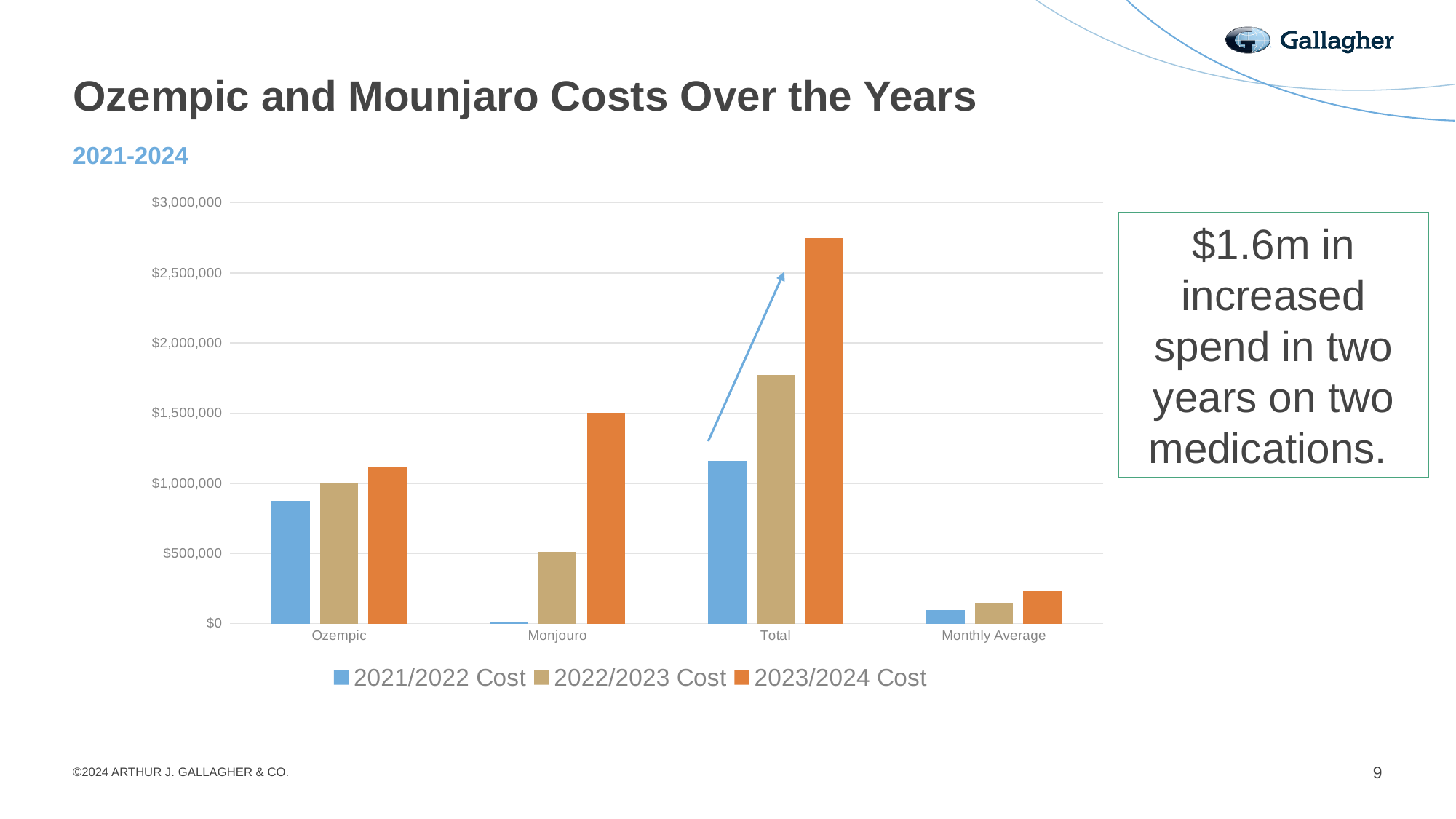
Is the 2023/2024 Cost value for Total greater or less than $2,500,000? greater How many categories are shown on the x axis of the chart? 4 Which colour represents the 2023/2024 Cost series in the chart? Orange Which category and series has the smallest bar in the chart? Monjouro, 2021/2022 Cost For the 2023/2024 Cost series, which is larger: Ozempic or Monjouro? Monjouro For the Total category, do the values rise or fall from 2021/2022 Cost to 2023/2024 Cost? Rise What kind of chart is shown on the slide? Bar chart Is the 2022/2023 Cost value for Total greater or less than $1,500,000? greater How many series does the chart's legend list? 3 Is the 2021/2022 Cost value for Ozempic greater or less than $1,000,000? less Which category and series has the tallest bar in the chart? Total, 2023/2024 Cost